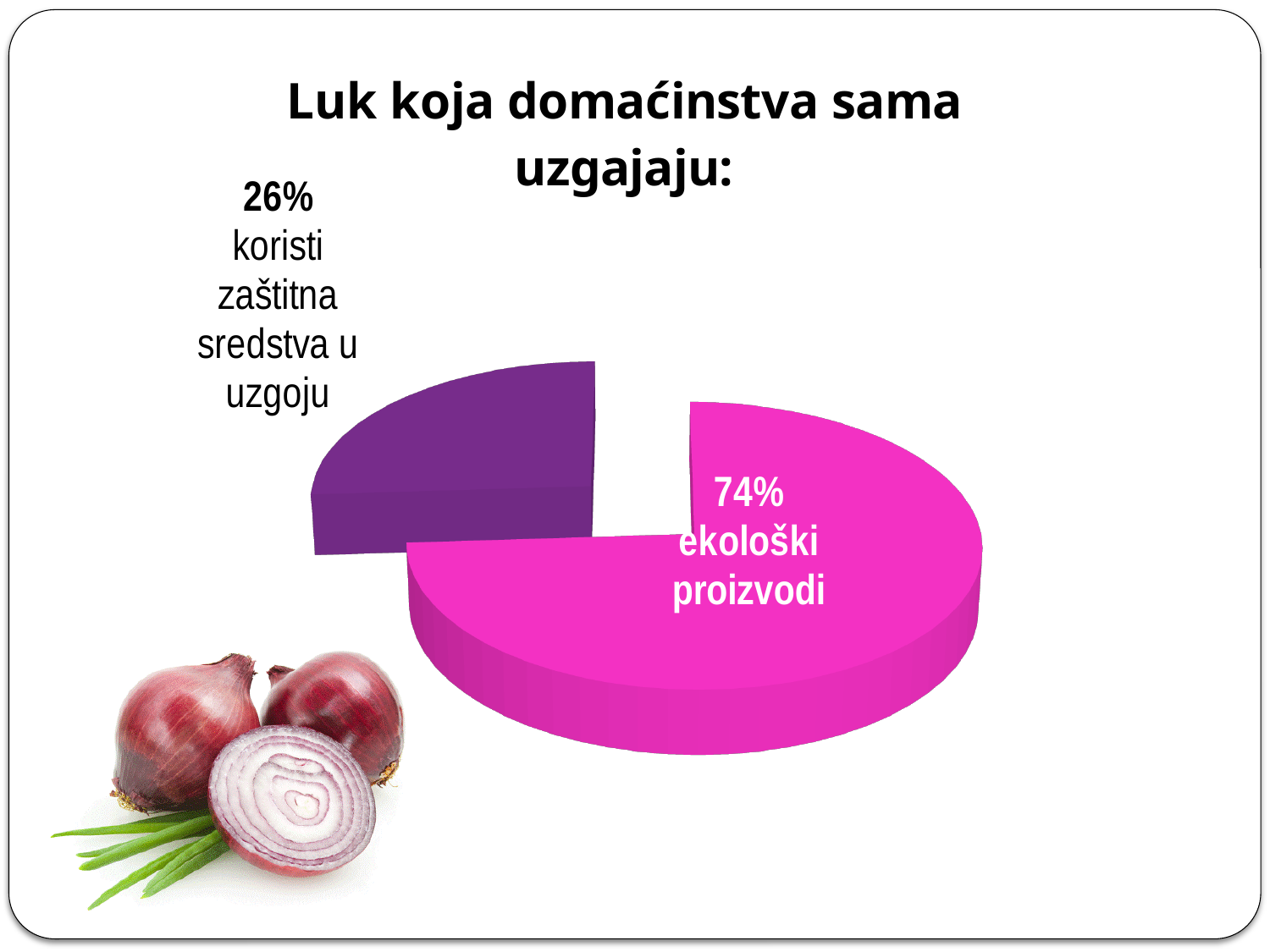
Which slice of the pie is the largest? ekološki proizvodi What is the title of the chart? Luk koja domaćinstva sama uzgajaju: Which slice of the pie is the smallest? koristi zaštitna sredstva u uzgoju What is the total of the two slice percentages shown on the pie chart? 100% What share of the pie is labelled "koristi zaštitna sredstva u uzgoju"? 26% Which is larger: the share for "ekološki proizvodi" or the share for "koristi zaštitna sredstva u uzgoju"? ekološki proizvodi What colour is the "ekološki proizvodi" slice? pink (magenta) What is the difference in percentage points between the "ekološki proizvodi" slice and the "koristi zaštitna sredstva u uzgoju" slice? 48 What kind of chart is shown on the slide? pie chart What share of the pie is labelled "ekološki proizvodi"? 74% How many slices does the pie chart have? 2